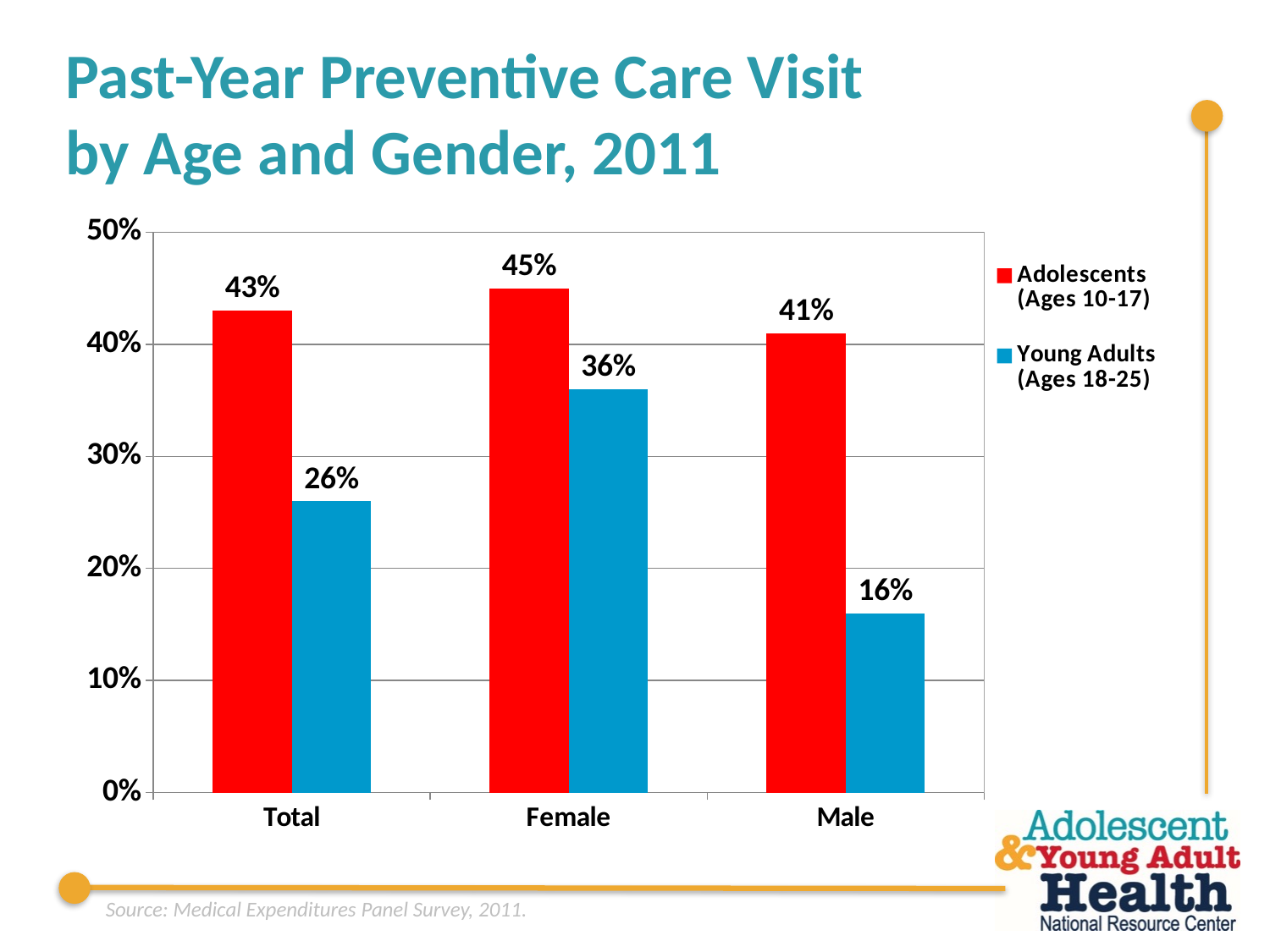
How many series does the legend list? 2 What is the difference between the Female and Total values for Young Adults (Ages 18-25)? 10 percentage points What is the value for Young Adults (Ages 18-25) in the Female category? 36% How many categories are shown on the x axis? 3 Which category has the lowest value for Young Adults (Ages 18-25)? Male Is the value for Young Adults (Ages 18-25) in the Total category greater or less than 30%? less Which category has the highest value for Adolescents (Ages 10-17)? Female What is the value for Young Adults (Ages 18-25) in the Male category? 16% What kind of chart is shown on the slide? Bar chart What is the difference between the Adolescents and Young Adults values in the Male category? 25 percentage points What is the value for Adolescents (Ages 10-17) in the Total category? 43% Which is larger: the Adolescents value for Total or the Adolescents value for Male? Total